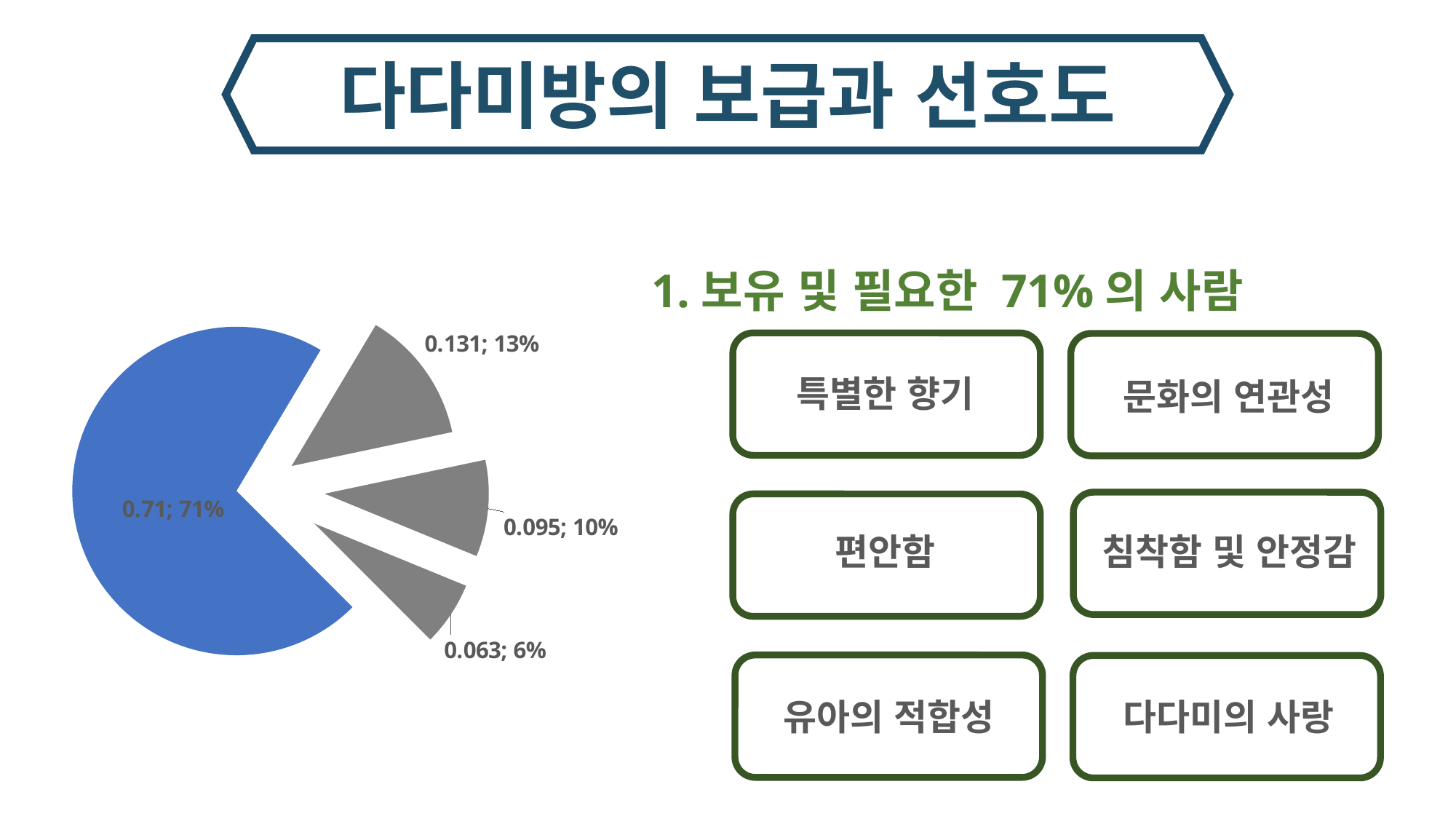
How many slices does the pie chart have? 4 What percentage is shown on the large blue slice of the pie chart? 71% Which is larger in the pie chart: the slice labelled 13% or the slice labelled 10%? the slice labelled 13% What is the share of the largest slice of the pie chart? 71% What colour is the largest slice of the pie chart? blue What value is printed on the blue slice of the pie chart? 0.71 What value is printed on the topmost grey slice of the pie chart? 0.131 What value is printed on the bottom grey slice of the pie chart? 0.063 What percentage is shown on the middle grey slice of the pie chart? 10% What is the share of the smallest slice of the pie chart? 6% What kind of chart is shown on the left of the slide? pie chart What is the difference in percentage points between the 71% slice and the 13% slice of the pie chart? 58%